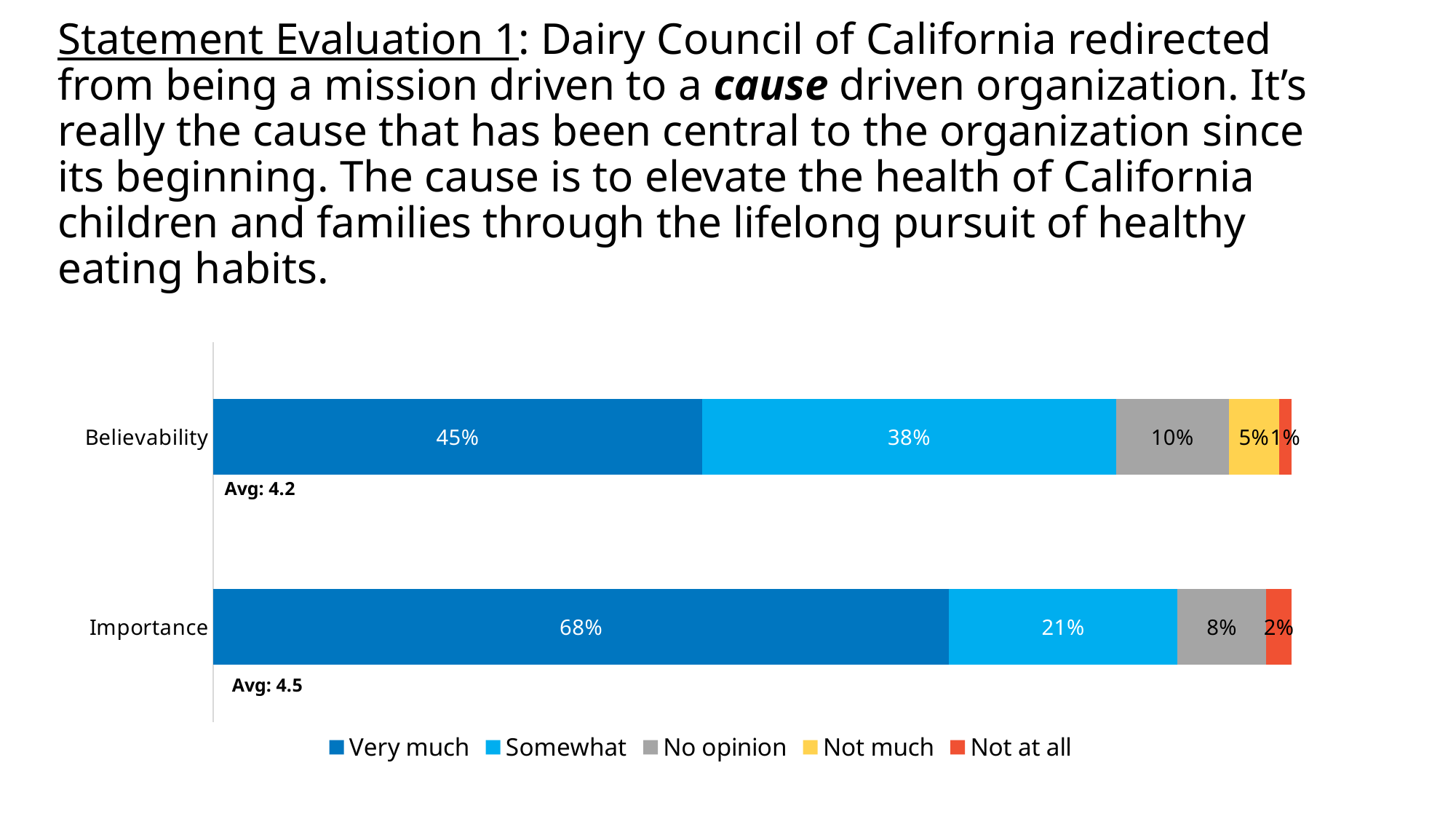
What is the "Somewhat" value for Believability? 38% What percentage of respondents answered "Very much" for Believability? 45% How many categories are shown on the chart? 2 What is the "Not much" value for Believability? 5% What is the "No opinion" value for Importance? 8% How many series does the legend list? 5 What is the average score shown for Importance? 4.5 What is the difference between the "Very much" percentages for Importance and Believability? 23% What percentage of respondents answered "Very much" for Importance? 68% Which category has the higher "Very much" percentage, Believability or Importance? Importance What kind of chart is shown on the slide? Stacked bar chart Which response option is shown in red in the legend? Not at all